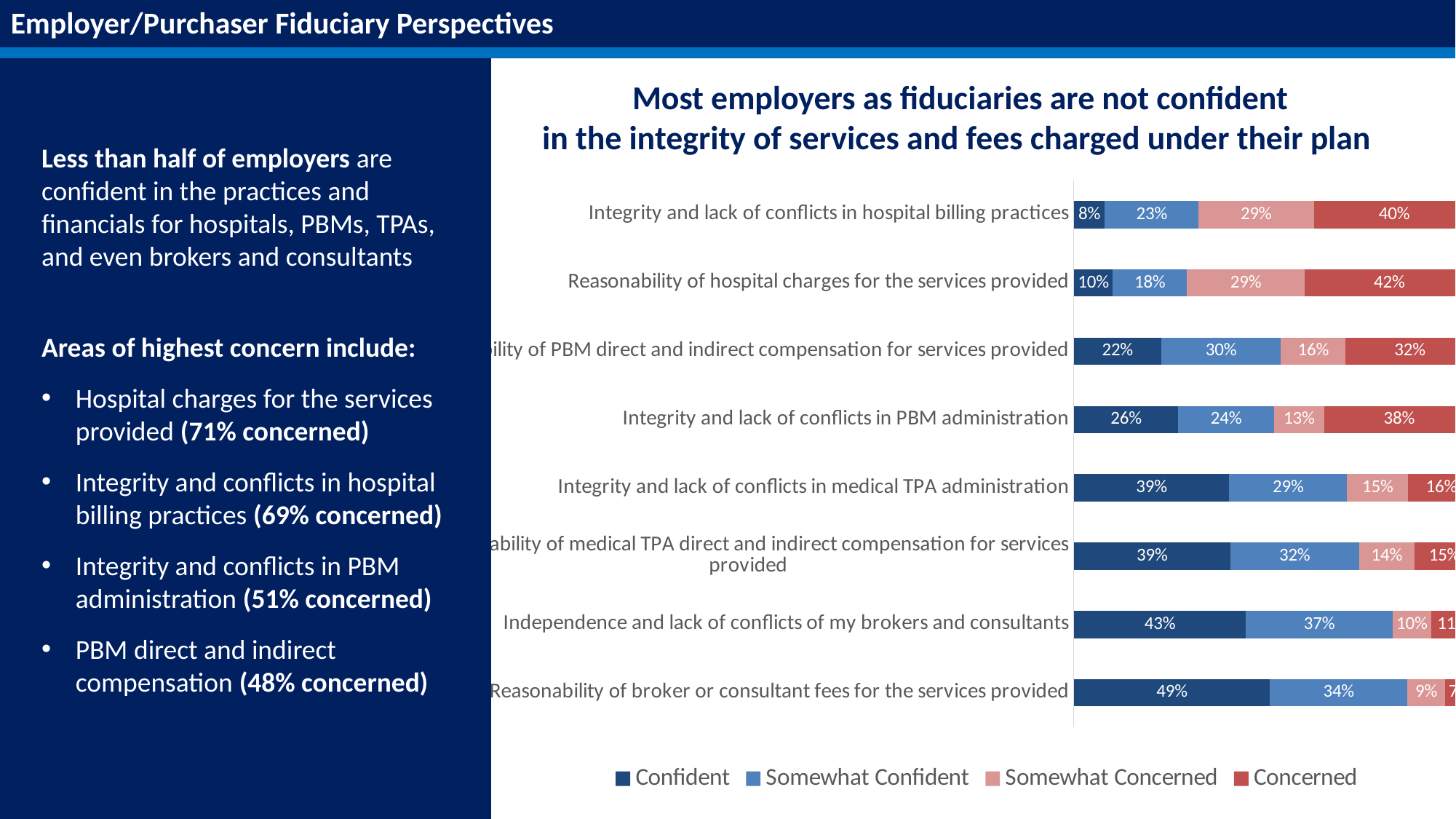
Which has a larger Confident share: independence and lack of conflicts of my brokers and consultants, or integrity and lack of conflicts in medical TPA administration? Independence and lack of conflicts of my brokers and consultants What percentage of employers are Concerned about integrity and lack of conflicts in hospital billing practices? 40% How many series does the legend list? 4 What is the Somewhat Confident value for integrity and lack of conflicts in PBM administration? 24% Which category has the highest Confident percentage? Reasonability of broker or consultant fees for the services provided What is the Somewhat Concerned value for independence and lack of conflicts of my brokers and consultants? 10% What is the combined Confident and Somewhat Confident share for integrity and lack of conflicts in hospital billing practices? 31% What percentage of employers are Confident in the reasonability of hospital charges for the services provided? 10% How many categories (bars) are shown in the chart? 8 What type of chart is shown on the slide? Stacked bar chart For integrity and lack of conflicts in hospital billing practices, how much larger is the Concerned share than the Confident share? 32 percentage points Which category has the highest Concerned percentage? Reasonability of hospital charges for the services provided